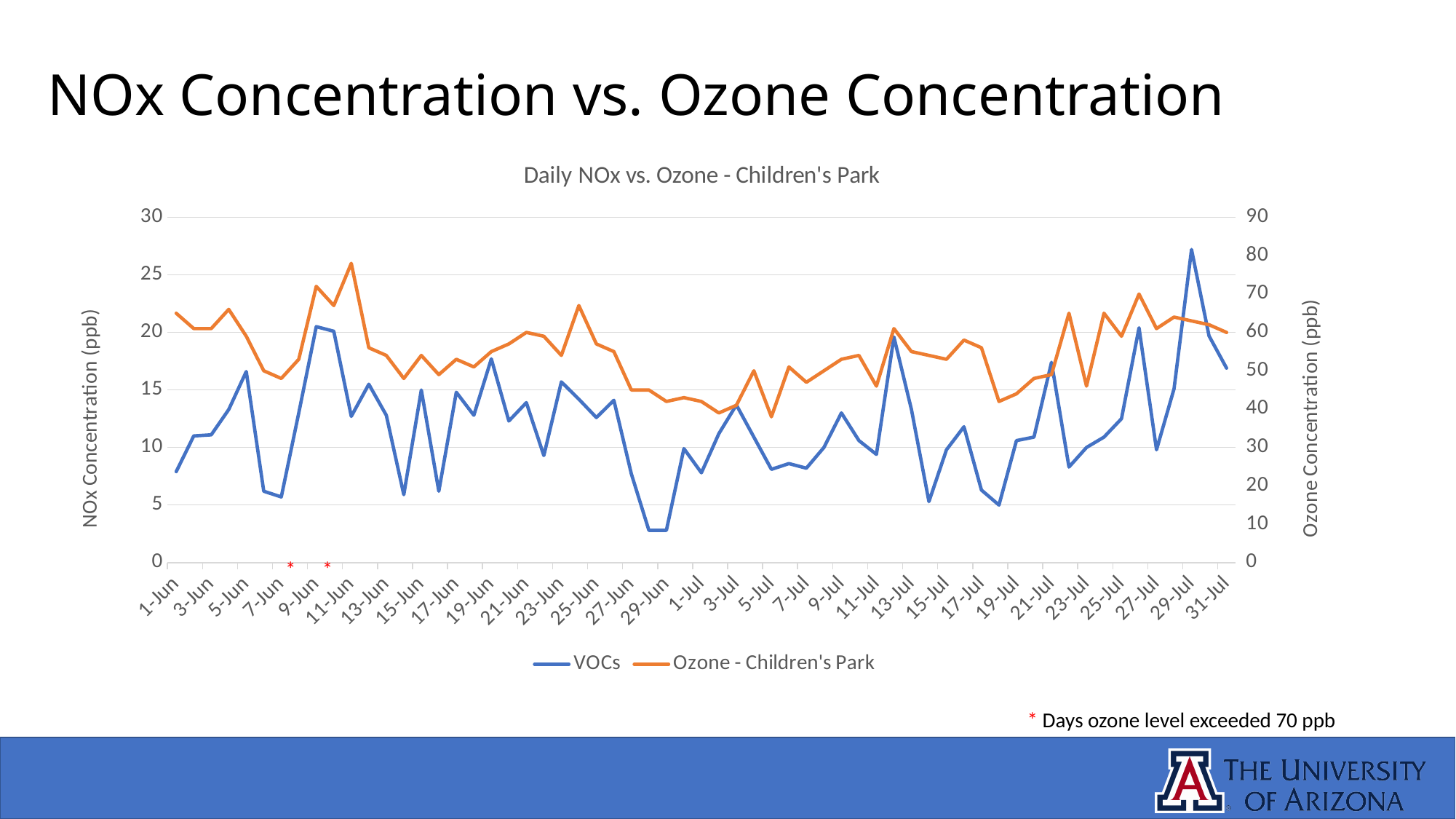
On which date does the VOCs series reach its highest value? 29-Jul What is the title of the chart? Daily NOx vs. Ozone - Children's Park Does the VOCs series rise or fall from 27-Jul to 29-Jul? rise Is the VOCs value on 28-Jun greater or less than 5? less How many series does the legend list? 2 Which series is drawn in orange? Ozone - Children's Park What type of chart is shown on the slide? line chart Is the VOCs value on 29-Jul greater or less than 25? greater Is the Ozone - Children's Park value on 29-Jun greater or less than 50? less On which date does the Ozone - Children's Park series reach its highest value? 11-Jun Does the Ozone - Children's Park series rise or fall from 10-Jun to 15-Jun? fall